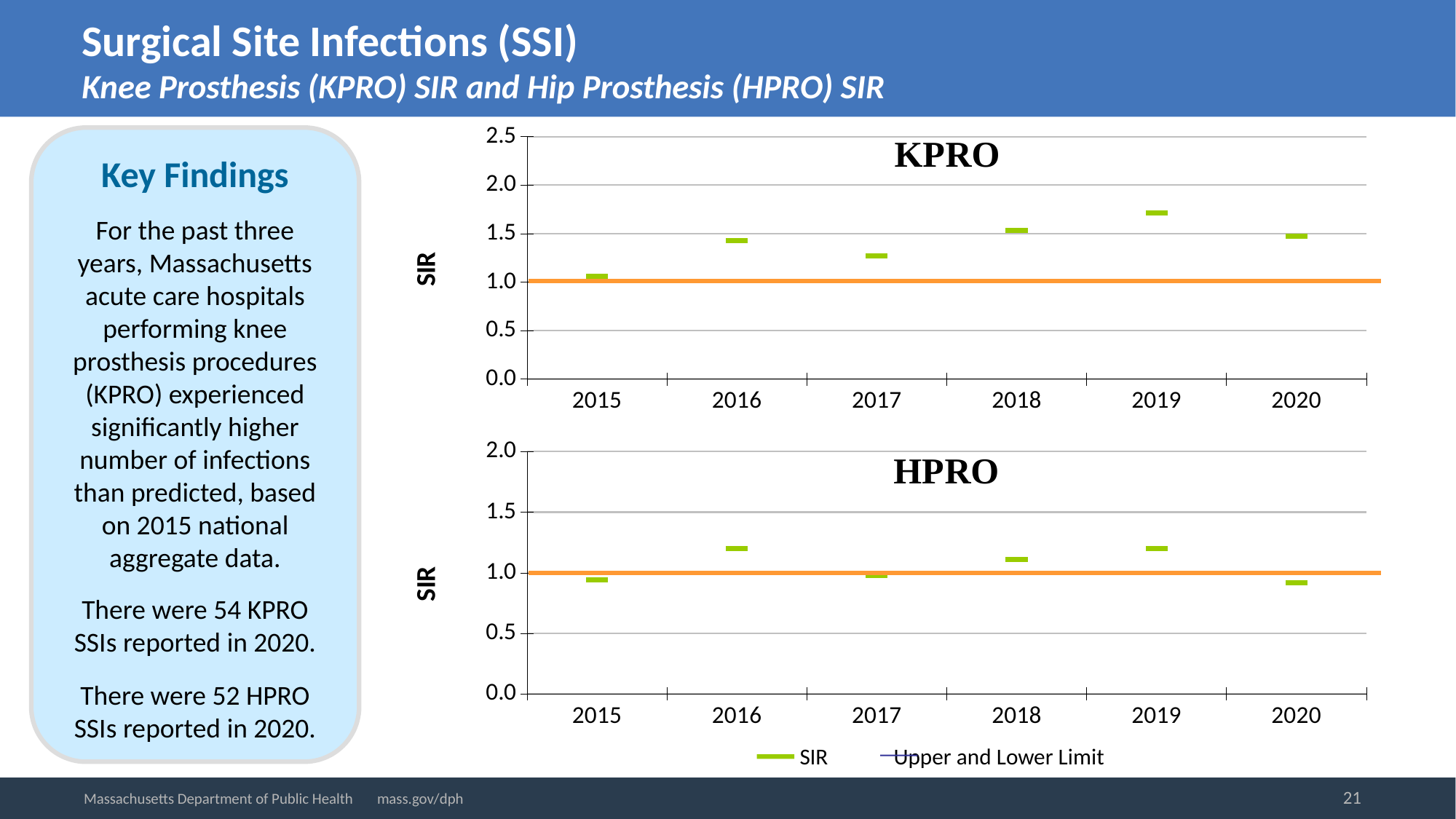
In the KPRO chart, which year has the lowest SIR? 2015 In the HPRO chart, is the SIR for 2020 greater or less than 1.0? less In the KPRO chart, at what value is the Upper and Lower Limit line drawn? 1.0 In the KPRO chart, which year has the larger SIR, 2017 or 2019? 2019 In the KPRO chart, which year has the highest SIR? 2019 In the HPRO chart, which year has the larger SIR, 2016 or 2020? 2016 In the KPRO chart, is the SIR for 2019 greater or less than 1.5? greater How many series does the legend below the HPRO chart list? 2 In the HPRO chart, is the SIR for 2016 greater or less than 1.0? greater What is the label on the y axis of the KPRO chart? SIR How many years are shown on the x axis of the HPRO chart? 6